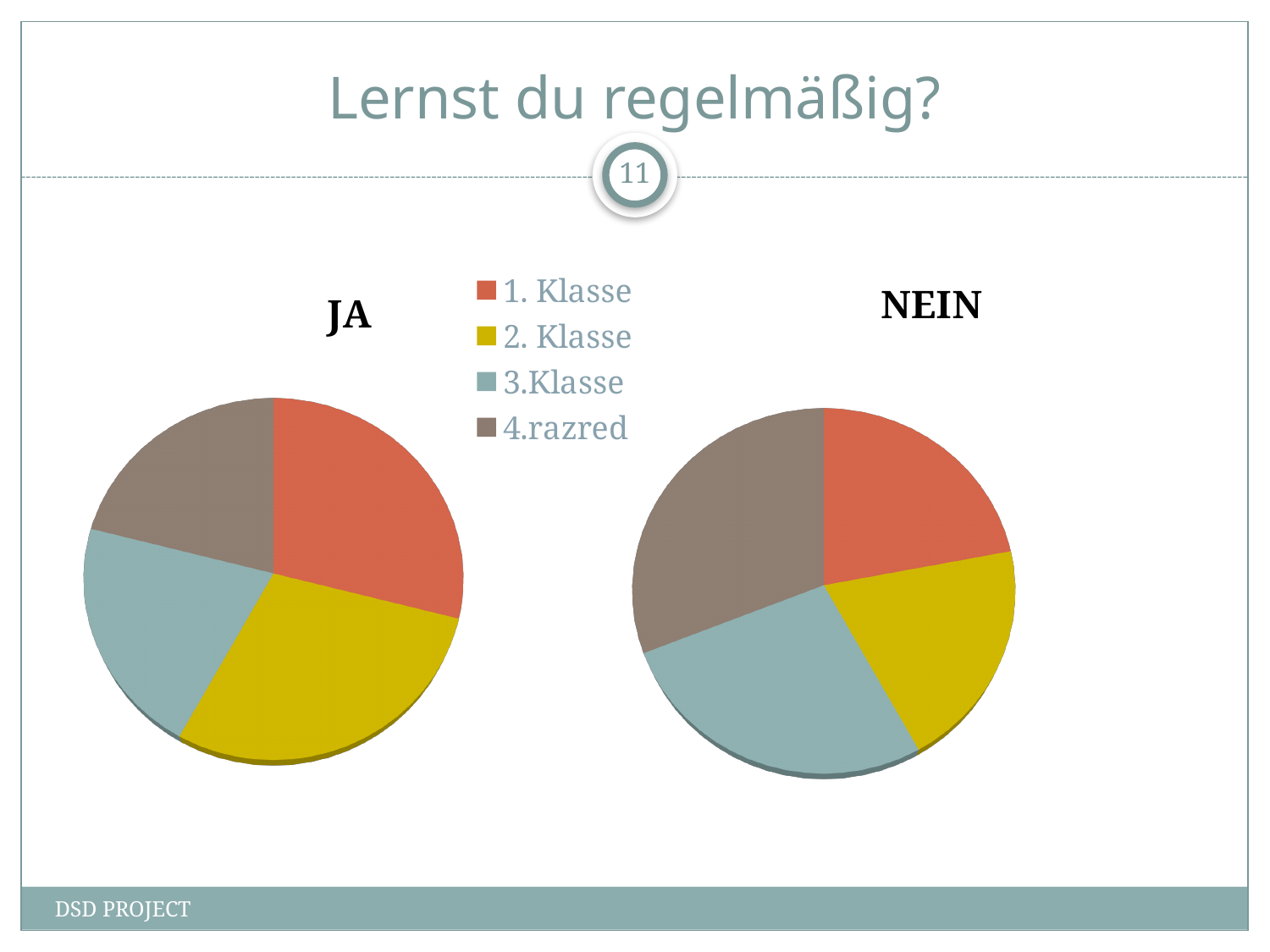
Which legend entry is shown in red in the pie charts? 1. Klasse What kind of chart is the chart titled "NEIN"? pie chart In the "JA" pie chart, which slice is larger: 2. Klasse or 3.Klasse? 2. Klasse How many entries does the legend between the two pie charts list? 4 How many slices does the "NEIN" pie chart have? 4 How many slices does the "JA" pie chart have? 4 In the "NEIN" pie chart, which slice is larger: 4.razred or 2. Klasse? 4.razred What kind of chart is the chart titled "JA"? pie chart What are the titles of the two pie charts on the slide? JA and NEIN In the "NEIN" pie chart, which slice is larger: 3.Klasse or 1. Klasse? 3.Klasse